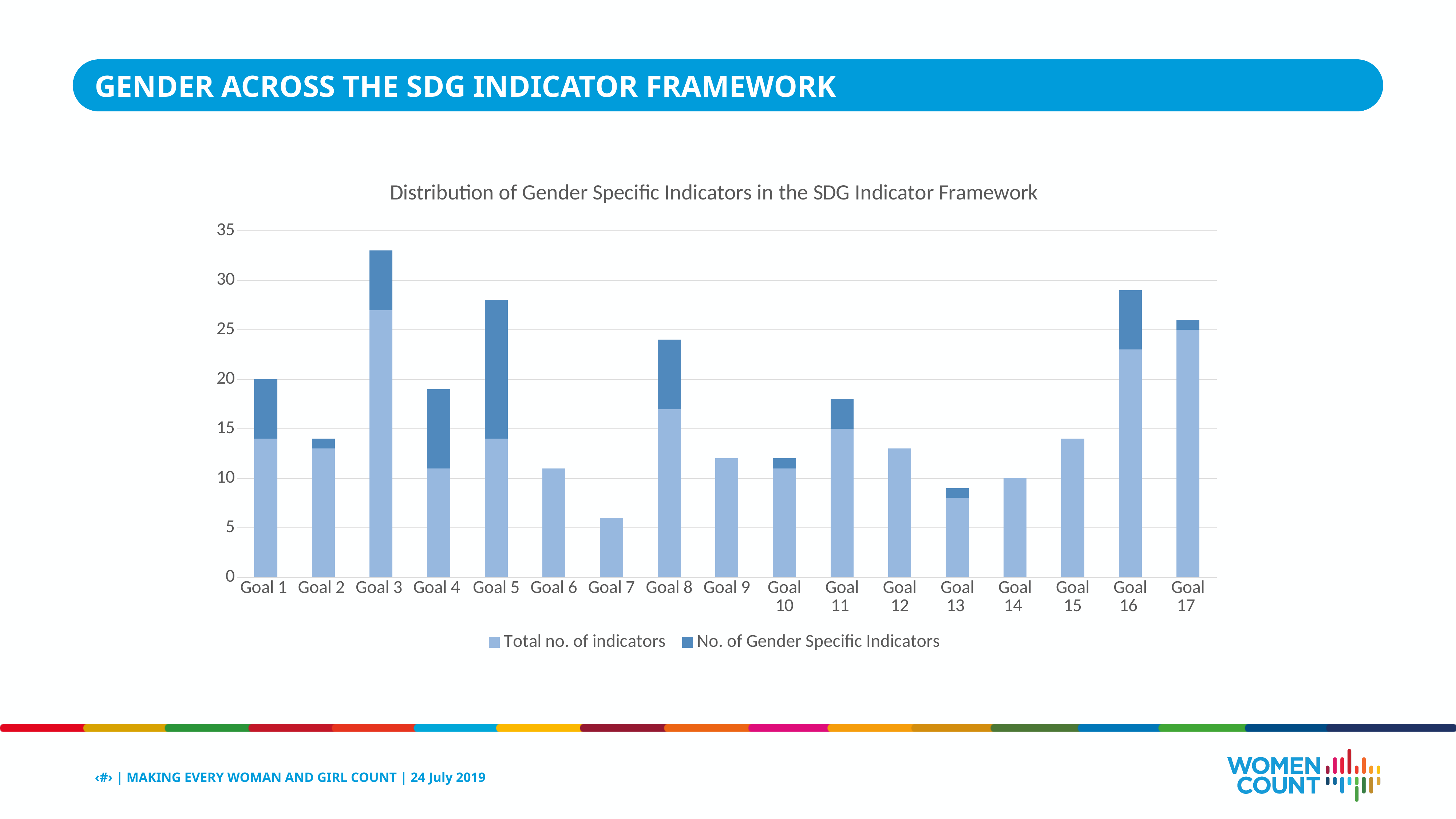
Is the total height of the stacked bar for Goal 16 greater or less than 25? greater What is the title of the chart? Distribution of Gender Specific Indicators in the SDG Indicator Framework What is the total height of the stacked bar for Goal 1? 20 Is the total height of the stacked bar for Goal 3 greater or less than 30? greater How many goals (categories) are shown on the x axis? 17 What is the total height of the stacked bar for Goal 14? 10 What kind of chart is shown on the slide? Stacked bar chart How many series does the legend list? 2 Which goal has the tallest stacked bar? Goal 3 Is the total height of the stacked bar for Goal 7 greater or less than 10? less Which stacked bar is taller, Goal 5 or Goal 8? Goal 5 Which goal has the shortest stacked bar? Goal 7